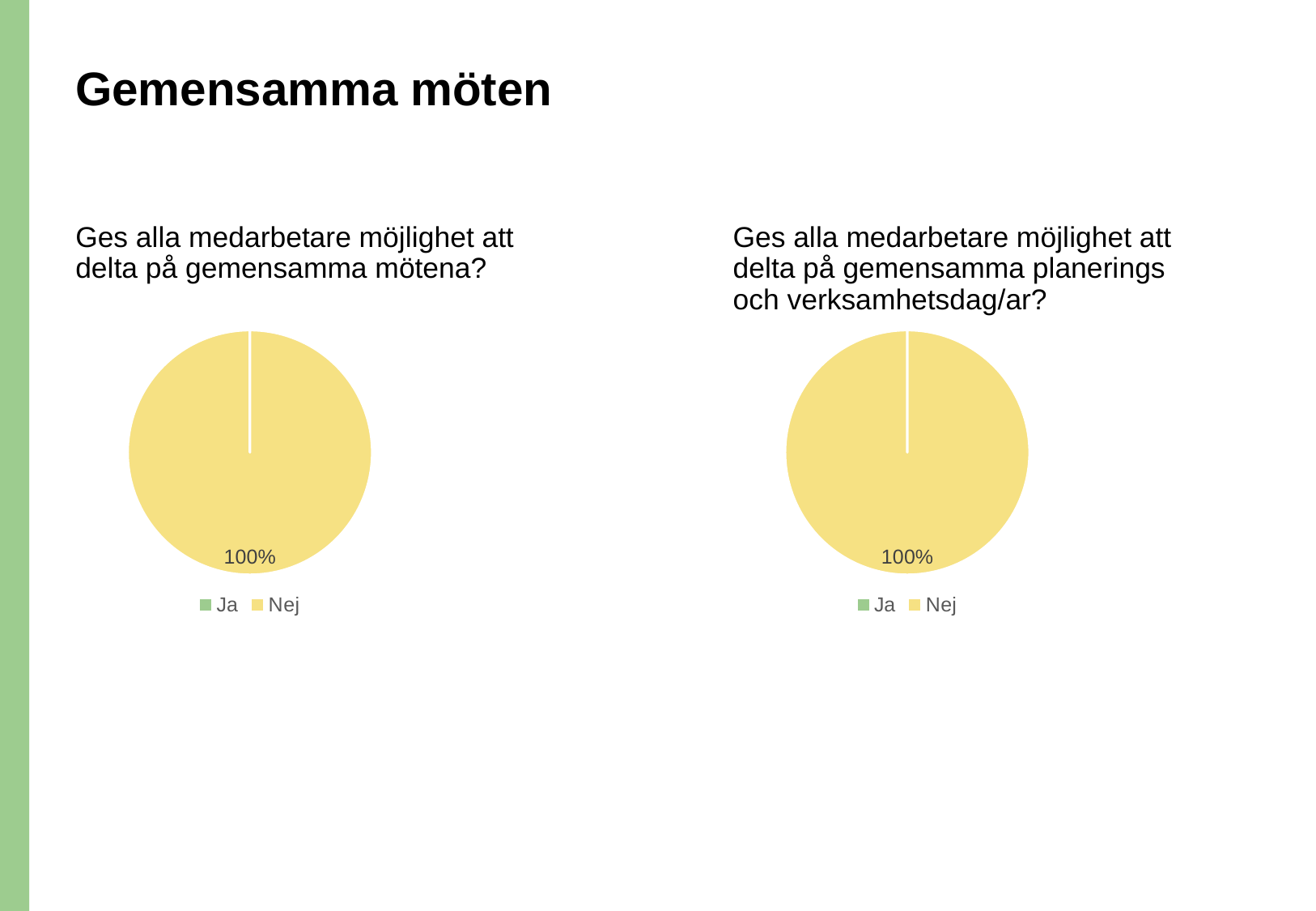
How many entries does the legend of the left pie chart list? 2 In the left pie chart, which is larger, Ja or Nej? Nej How many entries does the legend of the right pie chart list? 2 In the left pie chart, what colour represents Nej? yellow What kind of chart is shown on the right of the slide? pie chart What kind of chart is shown on the left of the slide? pie chart In the right pie chart, which category makes up the whole pie? Nej In the left pie chart ("Ges alla medarbetare möjlighet att delta på gemensamma mötena?"), what share is labelled on the pie? 100% In the right pie chart ("Ges alla medarbetare möjlighet att delta på gemensamma planerings och verksamhetsdag/ar?"), what share is labelled on the pie? 100% In the right pie chart, which is larger, Ja or Nej? Nej What is the title of the slide? Gemensamma möten In the left pie chart, which category makes up the whole pie? Nej